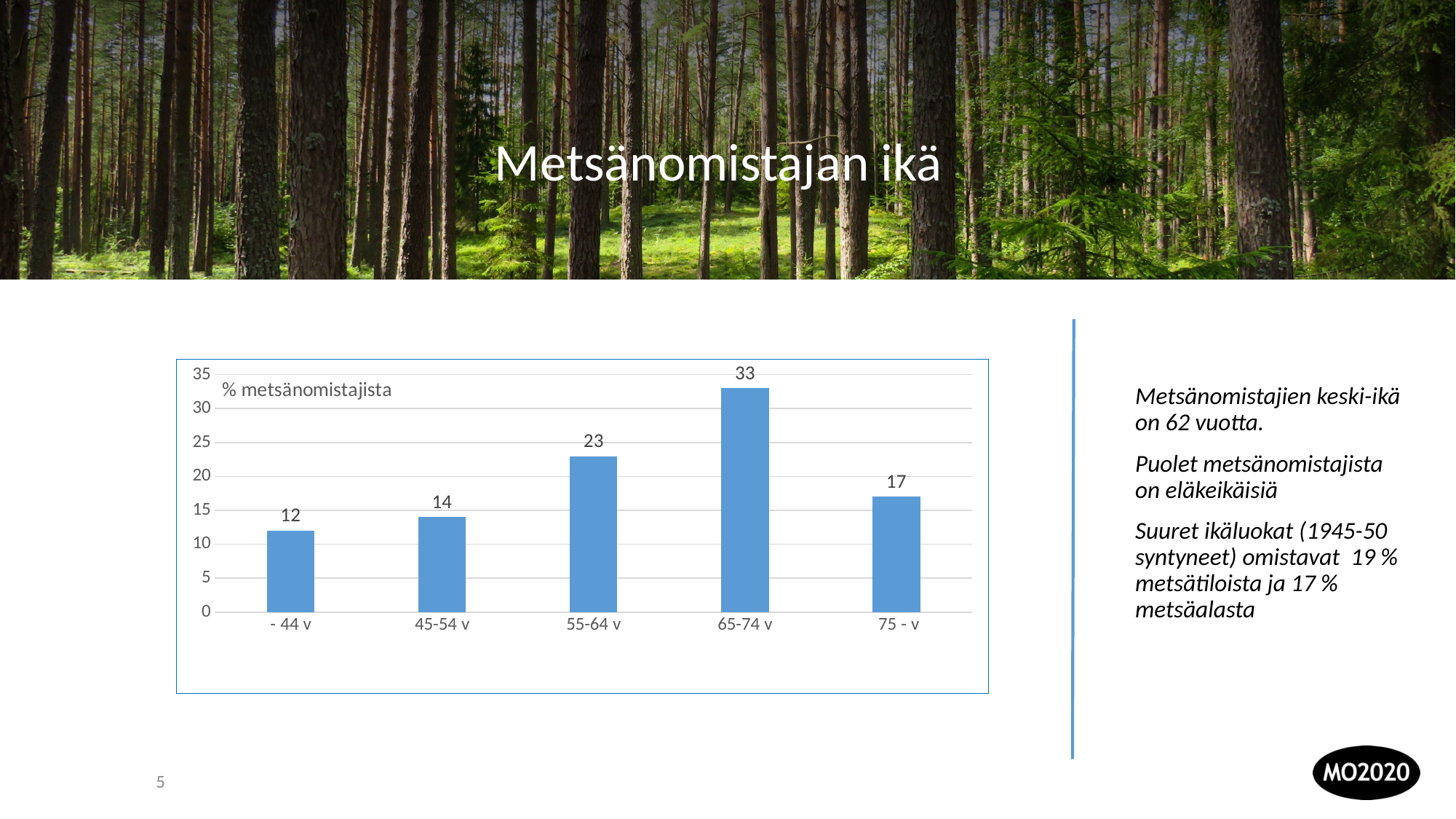
How many age groups are shown in the chart? 5 Which is larger, the value for 75 - v or the value for 45-54 v? 75 - v What is the difference between the values for 75 - v and 45-54 v? 3 Is the value for 55-64 v greater or less than 20? greater What kind of chart is shown on the slide? bar chart What is the axis label text shown inside the chart area? % metsänomistajista What is the value for the 55-64 v age group? 23 What is the value for the - 44 v age group? 12 What is the value for the 65-74 v age group? 33 Which age group has the lowest value? - 44 v What is the difference between the values for 65-74 v and 55-64 v? 10 Which age group has the highest value? 65-74 v